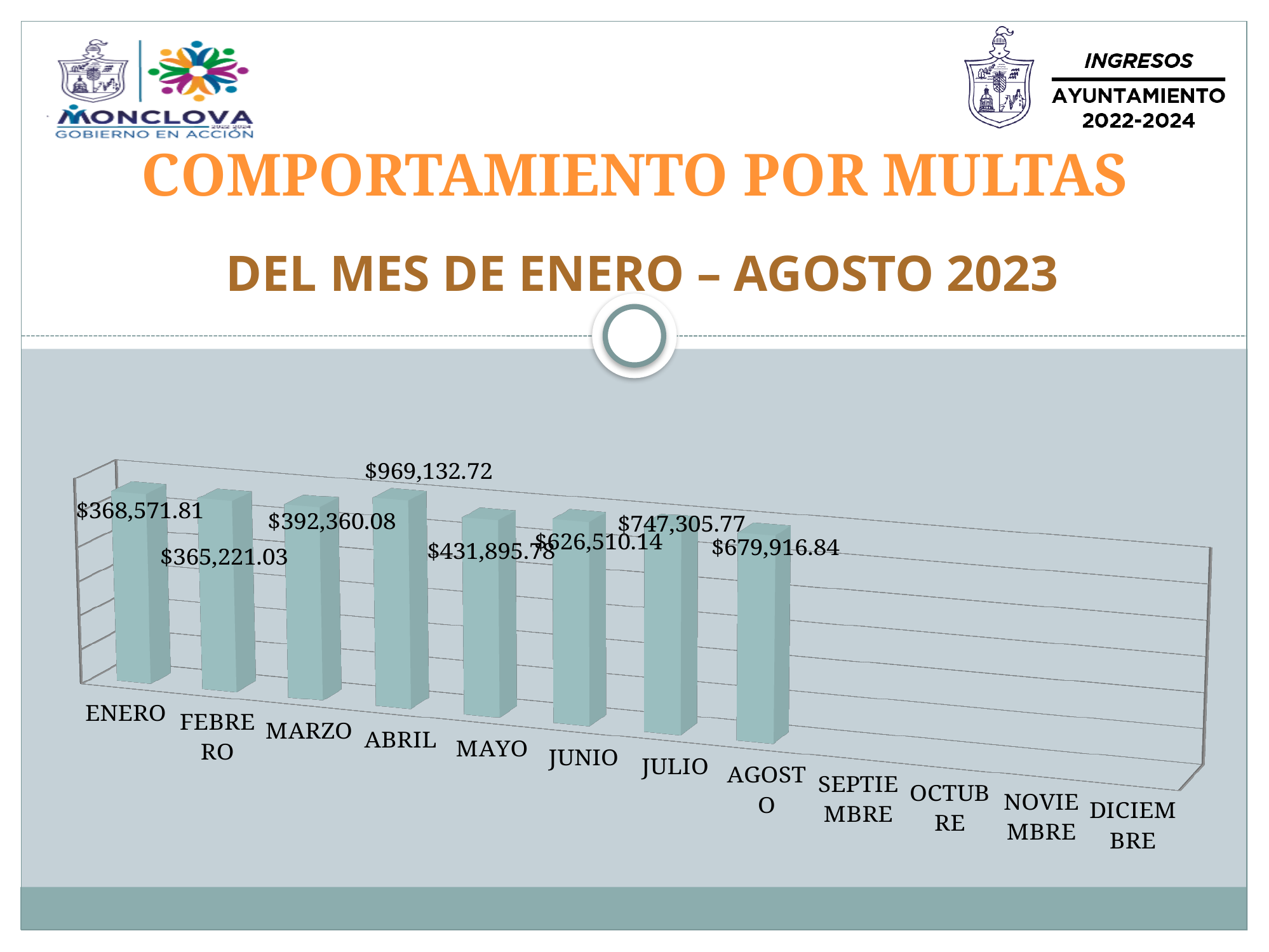
What kind of chart is shown on the slide? bar chart What is the value for ENERO? $368,571.81 Which is larger, the value for JULIO or the value for AGOSTO? JULIO Which month has the lowest value? FEBRERO Which month has the highest value? ABRIL What is the value for JUNIO? $626,510.14 Do the values rise or fall from FEBRERO to ABRIL? rise What is the value for AGOSTO? $679,916.84 What is the difference between the values for JULIO and JUNIO? $120,795.63 What is the value for ABRIL? $969,132.72 What is the difference between the values for ABRIL and MARZO? $576,772.64 How many months have a bar plotted in the chart? 8